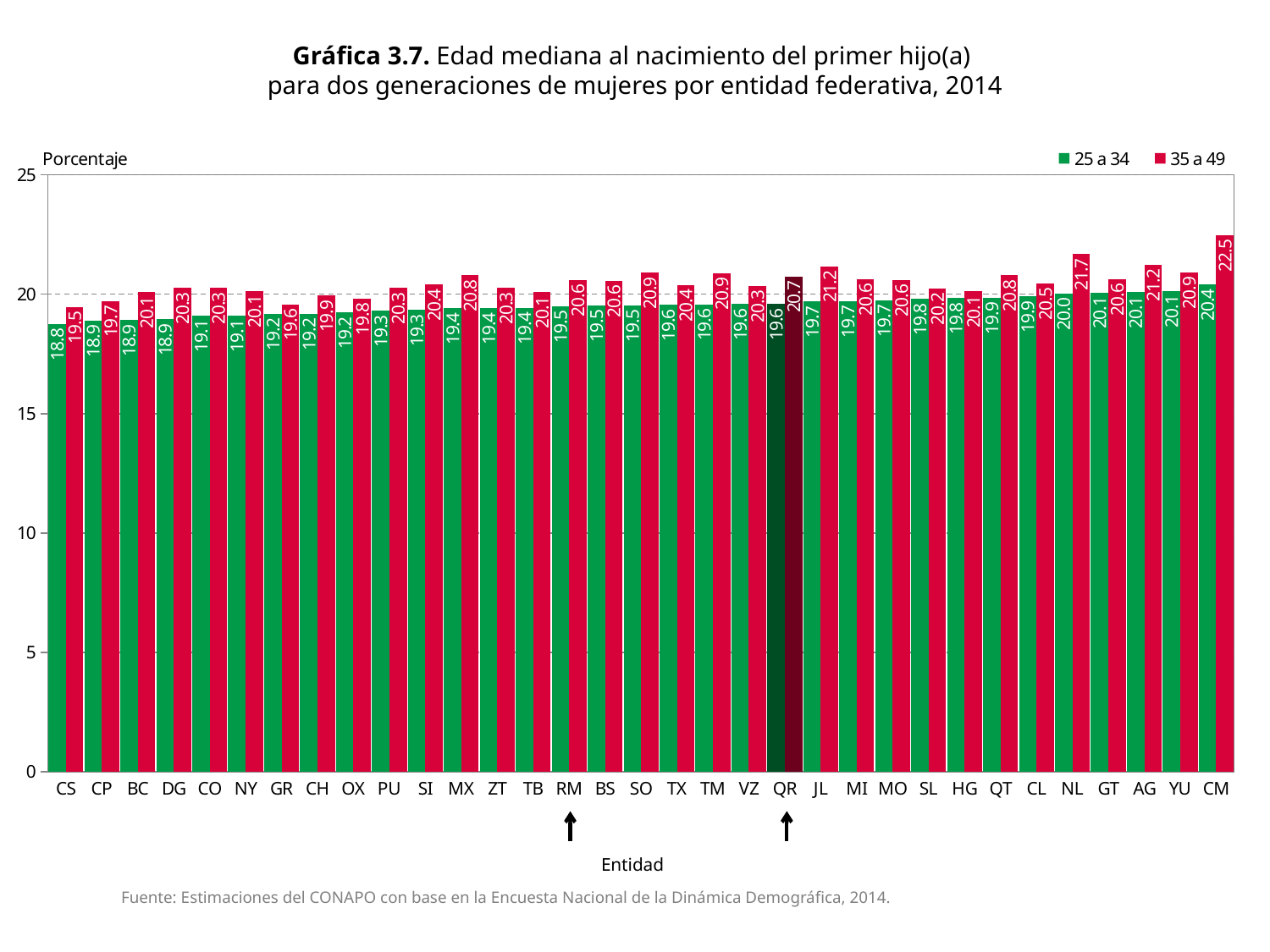
What is the value for CM in the 35 a 49 series? 22.5 What is the difference between the 35 a 49 and 25 a 34 values for CM? 2.1 What is the value for QR in the 25 a 34 series? 19.6 Which is larger for JL: the 25 a 34 value or the 35 a 49 value? 35 a 49 What is the value for NL in the 35 a 49 series? 21.7 What type of chart is shown on the slide? bar chart Which entity has the lowest value in the 25 a 34 series? CS How many entities are shown on the x axis? 33 Which entity has the highest value in the 35 a 49 series? CM What are the two series names listed in the legend? 25 a 34 and 35 a 49 How many series does the legend list? 2 Is the value for CS in the 25 a 34 series greater or less than 20? less